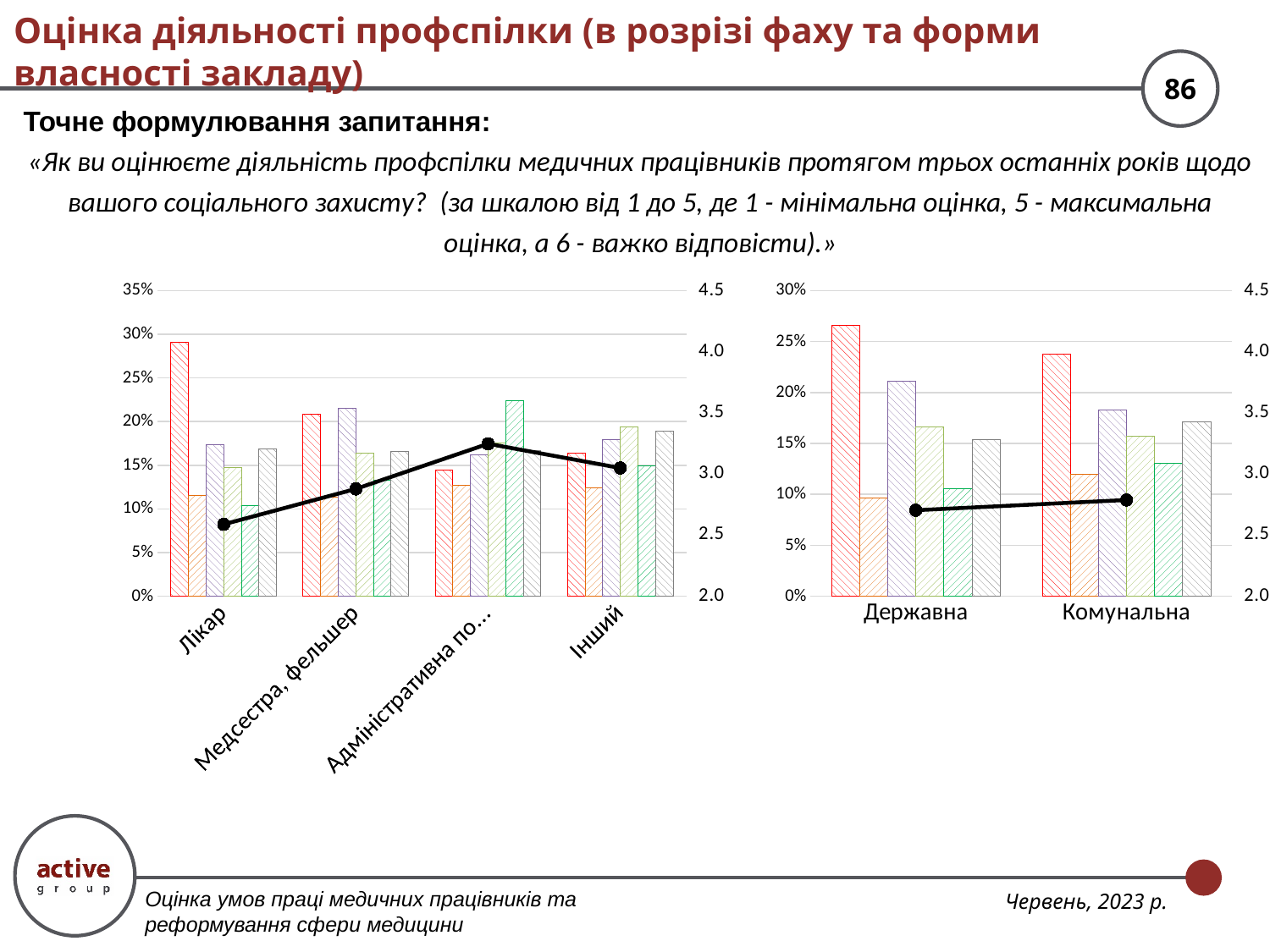
In the left chart, which category has the lowest point on the line? Лікар In the left chart, which category has the highest point on the line? Адміністративна по... What kind of chart is the left chart? bar chart with a line In the right chart, how many categories are shown on the x axis? 2 In the right chart, which category has the taller first (red) bar, Державна or Комунальна? Державна In the left chart, is the line value for Лікар greater or less than 3.0 on the right axis? less In the left chart, how many categories are shown on the x axis? 4 In the left chart, is the first (red) bar for Лікар greater or less than 25%? greater In the right chart, does the line rise or fall from Державна to Комунальна? rises In the right chart, is the first (red) bar for Державна greater or less than 25%? greater